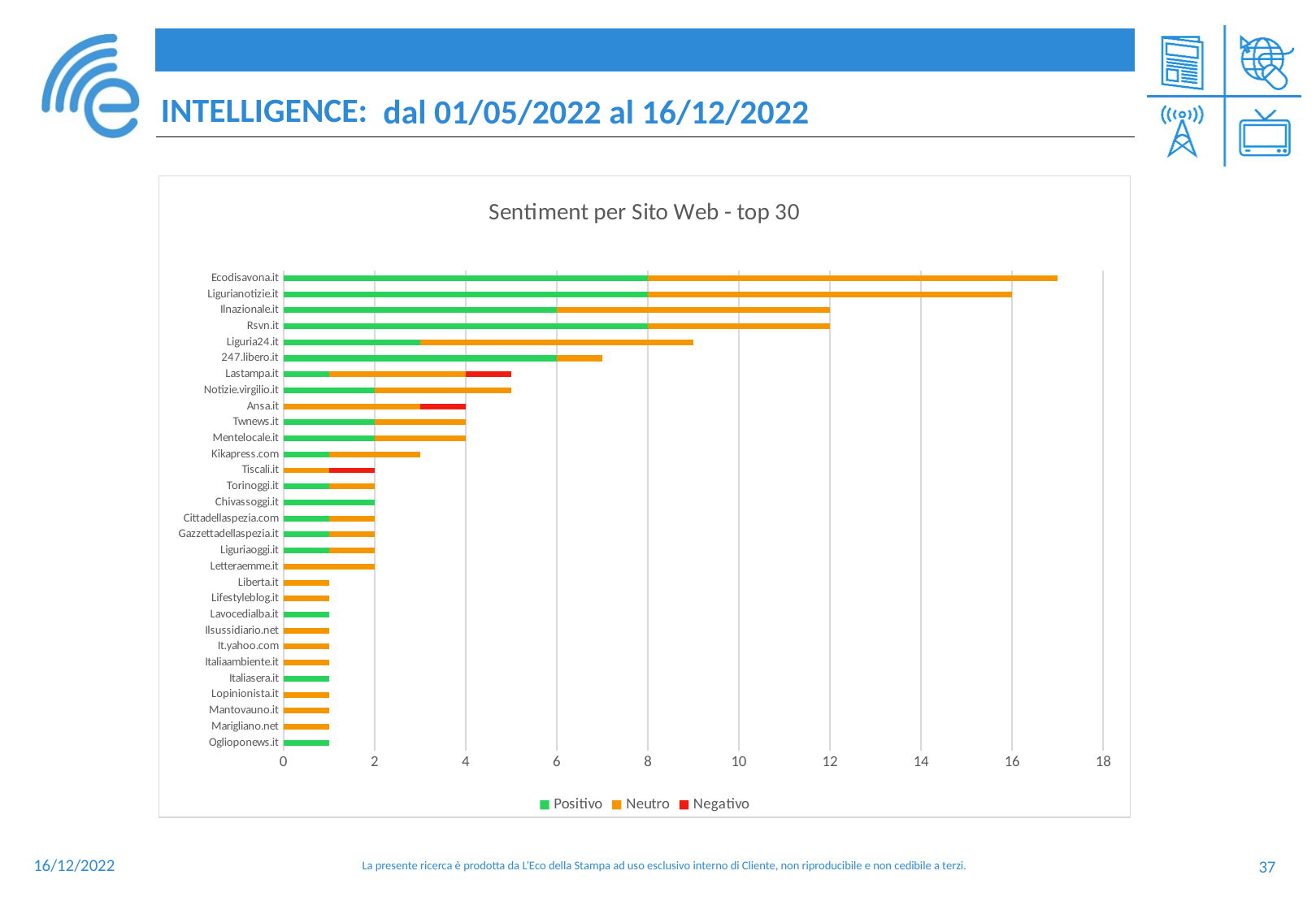
What type of chart is shown on the slide? bar chart Is the total value for Ecodisavona.it greater or less than 16? greater What is the title of the chart? Sentiment per Sito Web - top 30 What is the difference between the total bars of Ligurianotizie.it and Ilnazionale.it? 4 What is the total bar length for Rsvn.it? 12 How many series does the legend list? 3 Which website has the highest total bar? Ecodisavona.it How many websites are plotted in the chart? 30 Is the total value for Liguria24.it greater or less than 10? less What is the Positivo value for Ilnazionale.it? 6 What is the total bar length for Ligurianotizie.it? 16 What is the Positivo value for Ecodisavona.it? 8